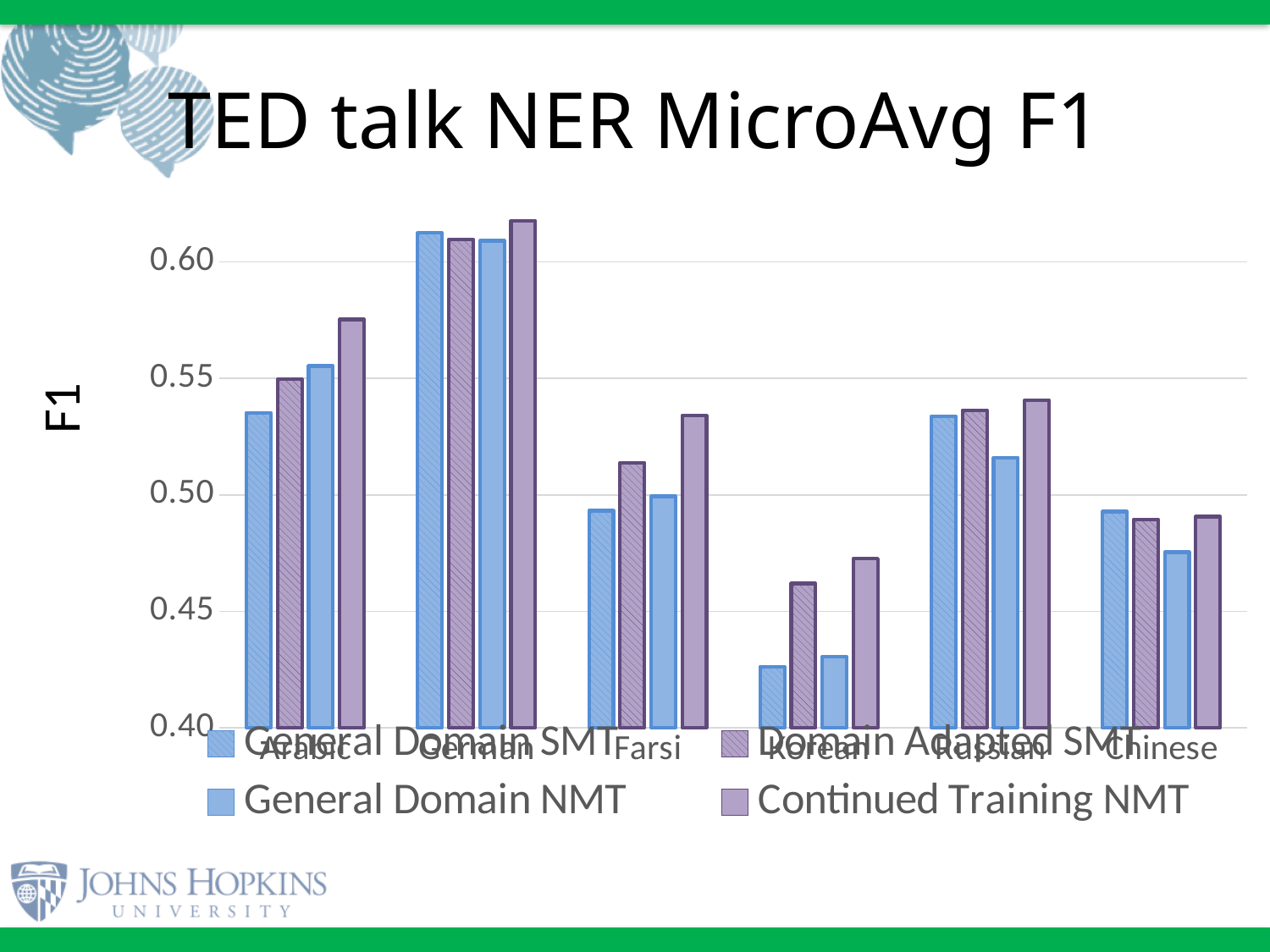
For Korean, which is larger: Domain Adapted SMT or General Domain NMT? Domain Adapted SMT How many languages are shown on the x axis of the chart? 6 What is the title of the chart? TED talk NER MicroAvg F1 Is the Continued Training NMT value for Arabic greater or less than 0.55? greater Is the Continued Training NMT value for German greater or less than 0.60? greater How many series does the legend list? 4 For Farsi, which is larger: General Domain SMT or Continued Training NMT? Continued Training NMT What kind of chart is shown on the slide? bar chart Which language has the lowest F1 for General Domain SMT? Korean Is the General Domain NMT value for Chinese greater or less than 0.50? less Which language has the highest F1 for Continued Training NMT? German